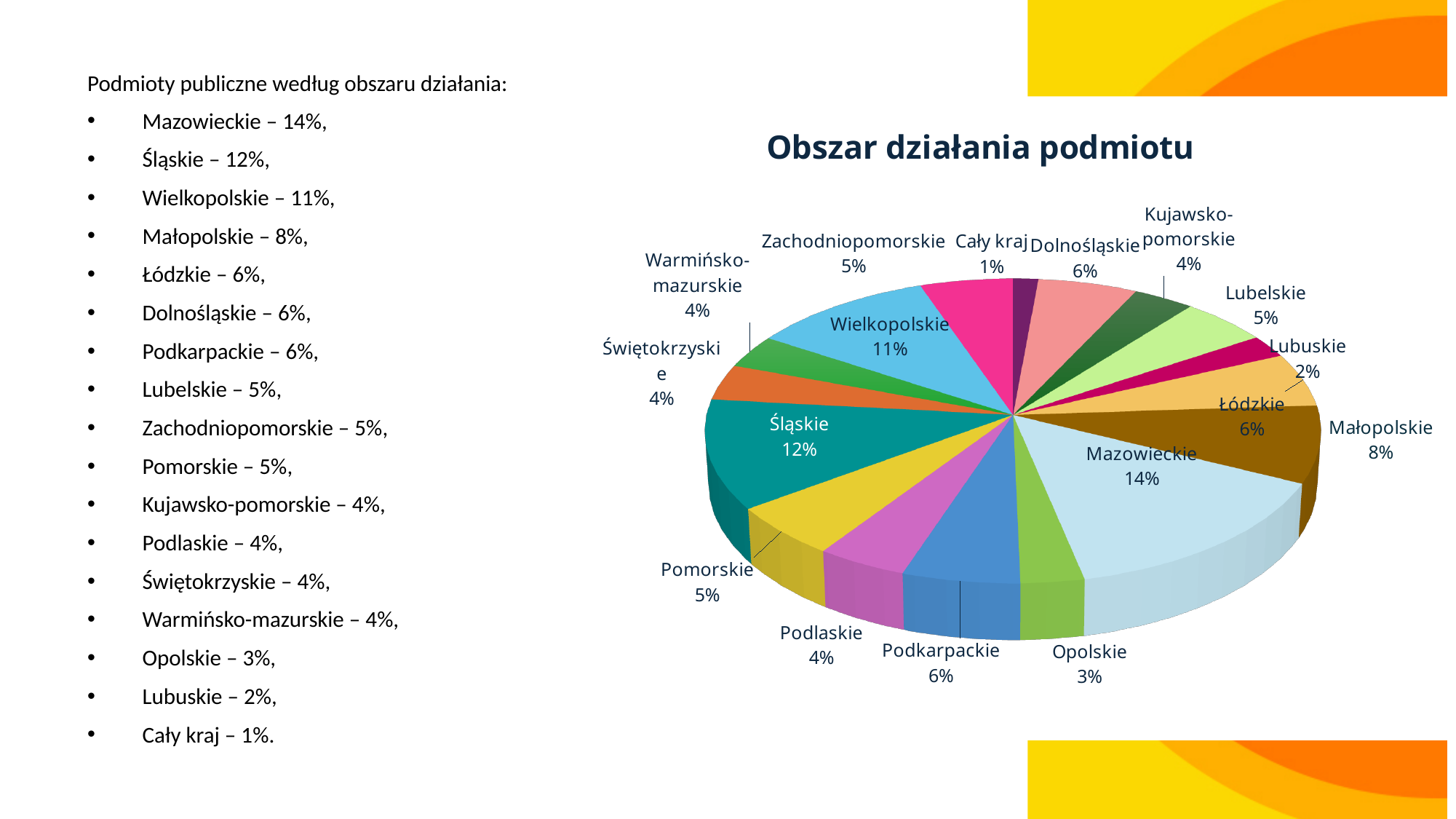
How many slices does the pie chart have? 17 What is the title of the chart? Obszar działania podmiotu Which slice of the pie is the smallest? Cały kraj What kind of chart is shown on the slide? pie chart What share of the pie does Mazowieckie have? 14% What is the difference between the values for Mazowieckie and Śląskie? 2% Which slice of the pie is the largest? Mazowieckie What is the value shown for Lubuskie? 2% What is the value shown for Opolskie? 3% Which is larger, the value for Małopolskie or the value for Łódzkie? Małopolskie What is the value shown for Wielkopolskie? 11% What is the difference between the values for Wielkopolskie and Małopolskie? 3%